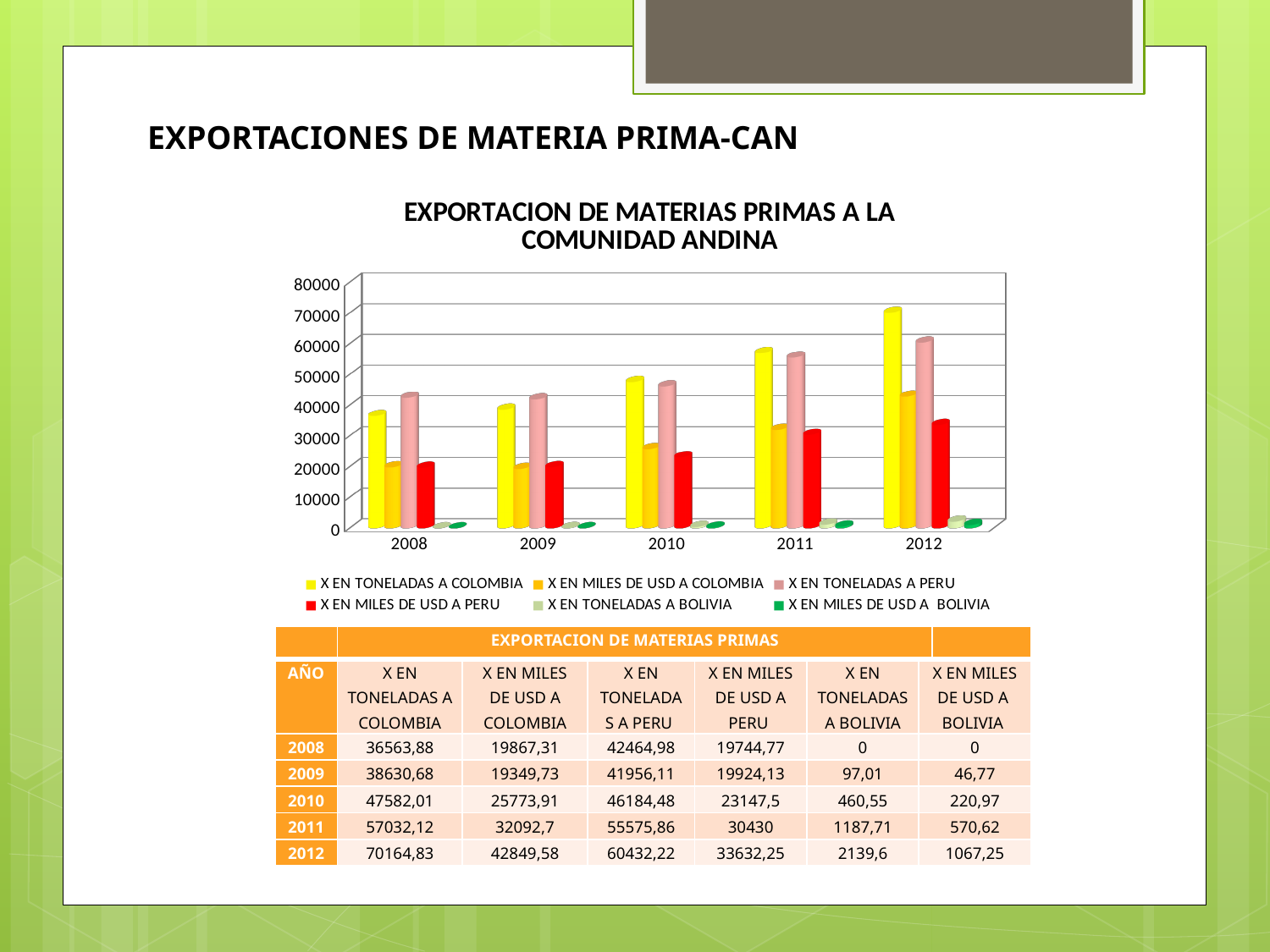
Which is larger in 2008, X EN TONELADAS A COLOMBIA or X EN TONELADAS A PERU? X EN TONELADAS A PERU What is the difference between X EN TONELADAS A COLOMBIA and X EN TONELADAS A PERU in 2012? 9732,61 How many series does the chart legend list? 6 What is the value of X EN TONELADAS A BOLIVIA for 2008? 0 In which year is X EN MILES DE USD A COLOMBIA lowest? 2009 What kind of chart is shown on the slide? bar chart Is the value of X EN TONELADAS A COLOMBIA for 2012 greater or less than 60000? greater Does X EN TONELADAS A COLOMBIA rise or fall from 2008 to 2012? rise What is the value of X EN TONELADAS A COLOMBIA for 2012? 70164,83 How many years are shown on the x axis of the chart? 5 In which year is X EN TONELADAS A COLOMBIA highest? 2012 What is the value of X EN MILES DE USD A PERU for 2011? 30430